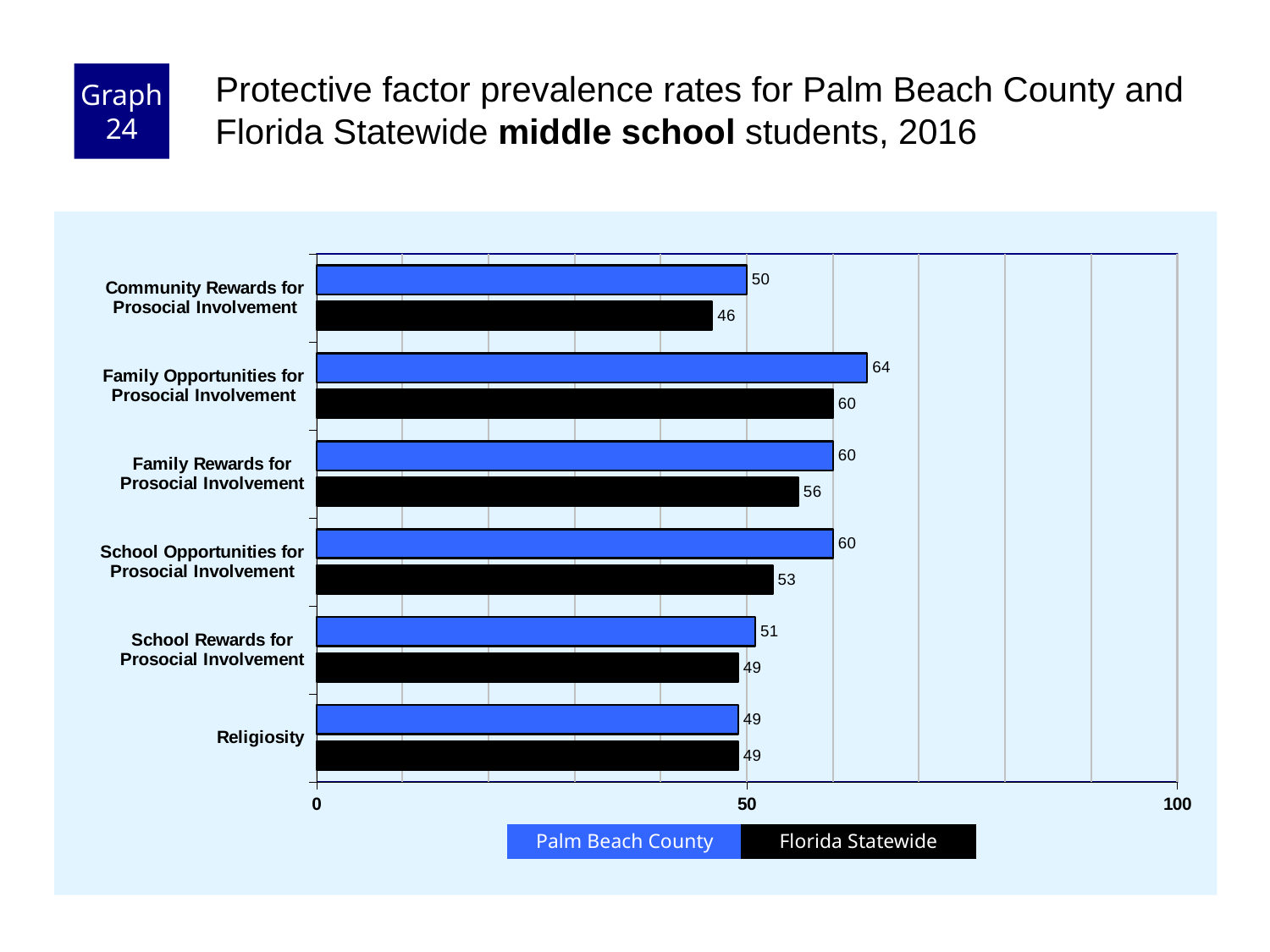
Which category has the lowest Florida Statewide value? Community Rewards for Prosocial Involvement Which is larger: the Florida Statewide value for Family Rewards for Prosocial Involvement or the Florida Statewide value for School Rewards for Prosocial Involvement? Family Rewards for Prosocial Involvement What is the difference between the Palm Beach County values for Family Opportunities for Prosocial Involvement and Religiosity? 15 What is the Florida Statewide value for Community Rewards for Prosocial Involvement? 46 What is the Palm Beach County value for Family Opportunities for Prosocial Involvement? 64 What kind of chart is shown on the slide? Bar chart What is the Florida Statewide value for School Opportunities for Prosocial Involvement? 53 What is the difference between the Palm Beach County and Florida Statewide values for School Opportunities for Prosocial Involvement? 7 How many categories are shown on the chart? 6 Which category has the highest Palm Beach County value? Family Opportunities for Prosocial Involvement Which colour represents Florida Statewide in the chart? Black How many series does the legend list? 2